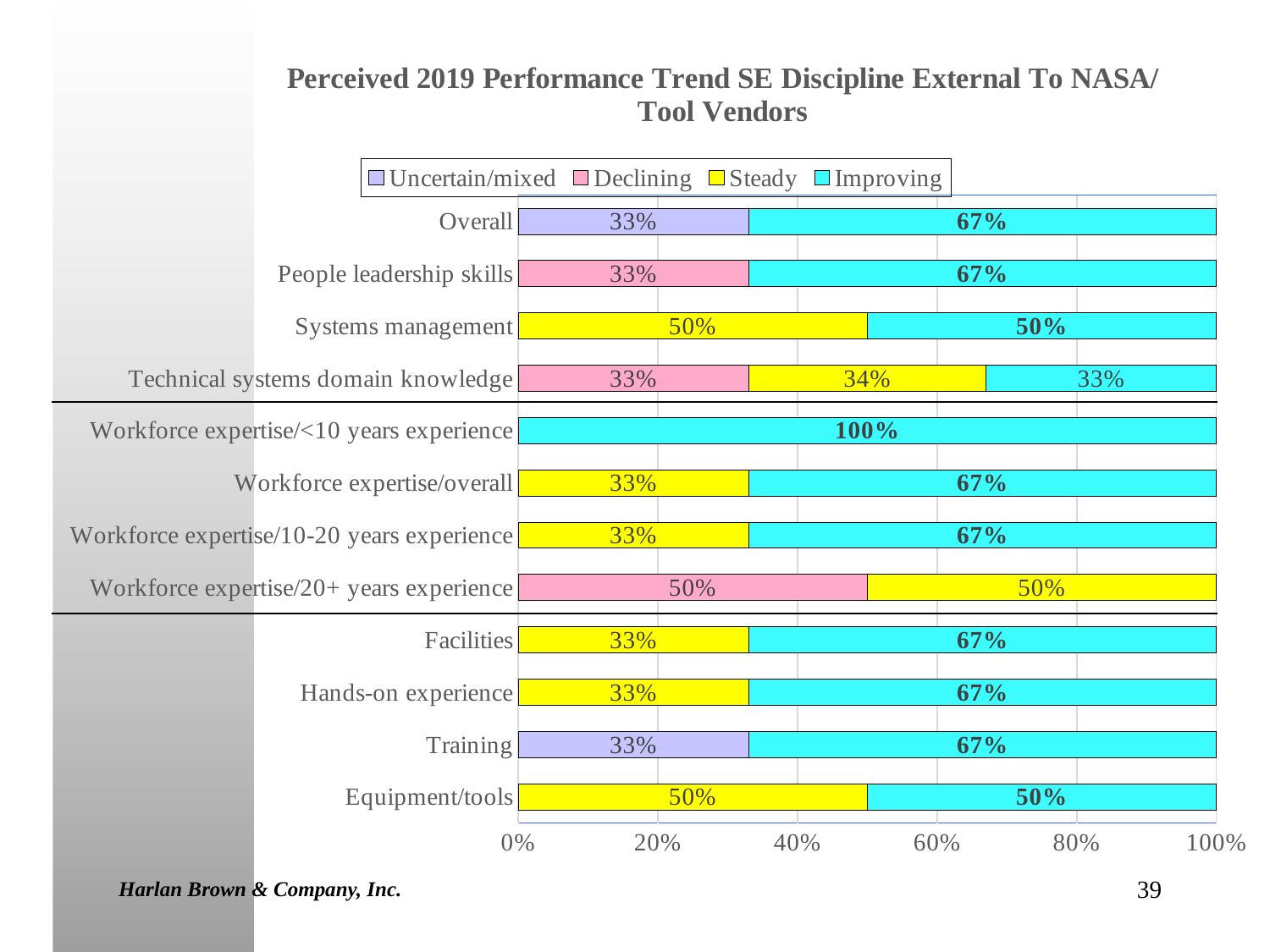
What is the Improving value for Overall? 67% What is the Steady value for Technical systems domain knowledge? 34% What is the Improving value for Workforce expertise/<10 years experience? 100% What is the difference between the Improving and Steady values for Facilities? 34% How many series does the legend list? 4 What kind of chart is shown on the slide? Stacked bar chart Which category has the highest Improving value? Workforce expertise/<10 years experience What is the title of the chart? Perceived 2019 Performance Trend SE Discipline External To NASA/ Tool Vendors Which is larger for Systems management, the Steady value or the Improving value? They are equal (50%) What is the Declining value for People leadership skills? 33% How many categories are plotted on the chart? 12 What is the Declining value for Workforce expertise/20+ years experience? 50%